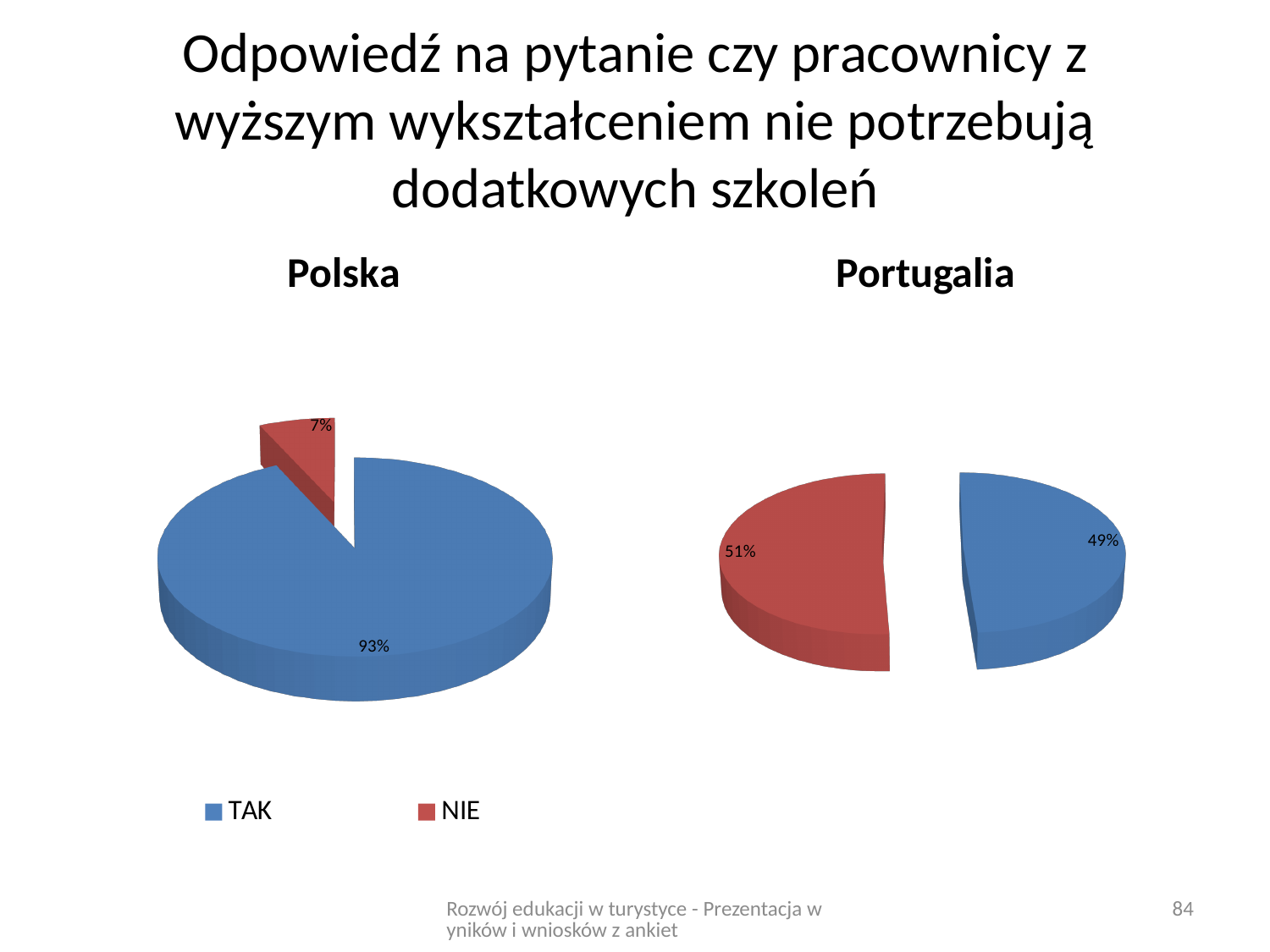
In the Polska chart, which answer has the largest slice? TAK How many entries does the legend list? 2 In the Polska chart, what share of responses is NIE? 7% In the Portugalia chart, what share of responses is TAK? 49% In the Polska chart, what share of responses is TAK? 93% Which chart has the larger TAK share, Polska or Portugalia? Polska What type of chart is used for Polska and Portugalia? Pie chart In the Polska chart, which answer has the smallest slice? NIE In the Portugalia chart, what share of responses is NIE? 51% In the Polska chart, what is the difference in percentage points between TAK and NIE? 86 In the Portugalia chart, what is the difference in percentage points between NIE and TAK? 2 How many slices does the Portugalia chart have? 2